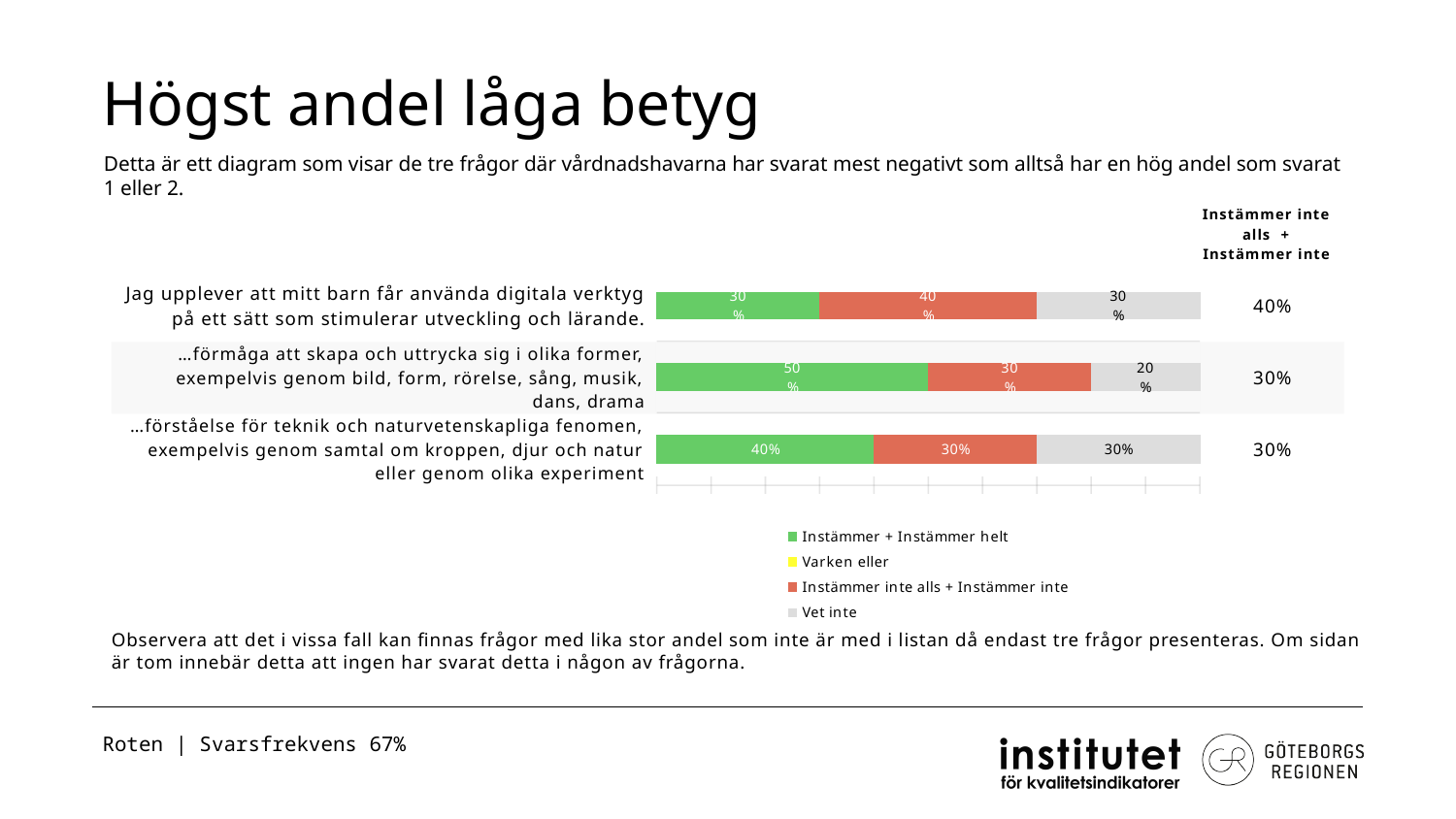
What kind of chart is shown on the slide? stacked bar chart How many categories (questions) are plotted in the chart? 3 How many series does the legend list? 4 What value is shown in the 'Instämmer inte alls + Instämmer inte' column to the right of the chart for the category 'Jag upplever att mitt barn får använda digitala verktyg…'? 40% Which category has the lowest 'Instämmer + Instämmer helt' value? Jag upplever att mitt barn får använda digitala verktyg på ett sätt som stimulerar utveckling och lärande. What is the total of the three labelled segments in the bar for '…förståelse för teknik och naturvetenskapliga fenomen…'? 100% Which category has the highest 'Instämmer + Instämmer helt' value? …förmåga att skapa och uttrycka sig i olika former, exempelvis genom bild, form, rörelse, sång, musik, dans, drama What is the difference between the 'Instämmer + Instämmer helt' value for '…förmåga att skapa och uttrycka sig i olika former…' and for 'Jag upplever att mitt barn får använda digitala verktyg…'? 20% Which is larger for the category 'Jag upplever att mitt barn får använda digitala verktyg…': the 'Instämmer + Instämmer helt' segment or the 'Instämmer inte alls + Instämmer inte' segment? Instämmer inte alls + Instämmer inte What is the value of the green 'Instämmer + Instämmer helt' segment for the category '…förmåga att skapa och uttrycka sig i olika former, exempelvis genom bild, form, rörelse, sång, musik, dans, drama'? 50% What is the value of the grey 'Vet inte' segment for the category '…förståelse för teknik och naturvetenskapliga fenomen, exempelvis genom samtal om kroppen, djur och natur eller genom olika experiment'? 30% What is the value of the red 'Instämmer inte alls + Instämmer inte' segment for the category 'Jag upplever att mitt barn får använda digitala verktyg på ett sätt som stimulerar utveckling och lärande.'? 40%